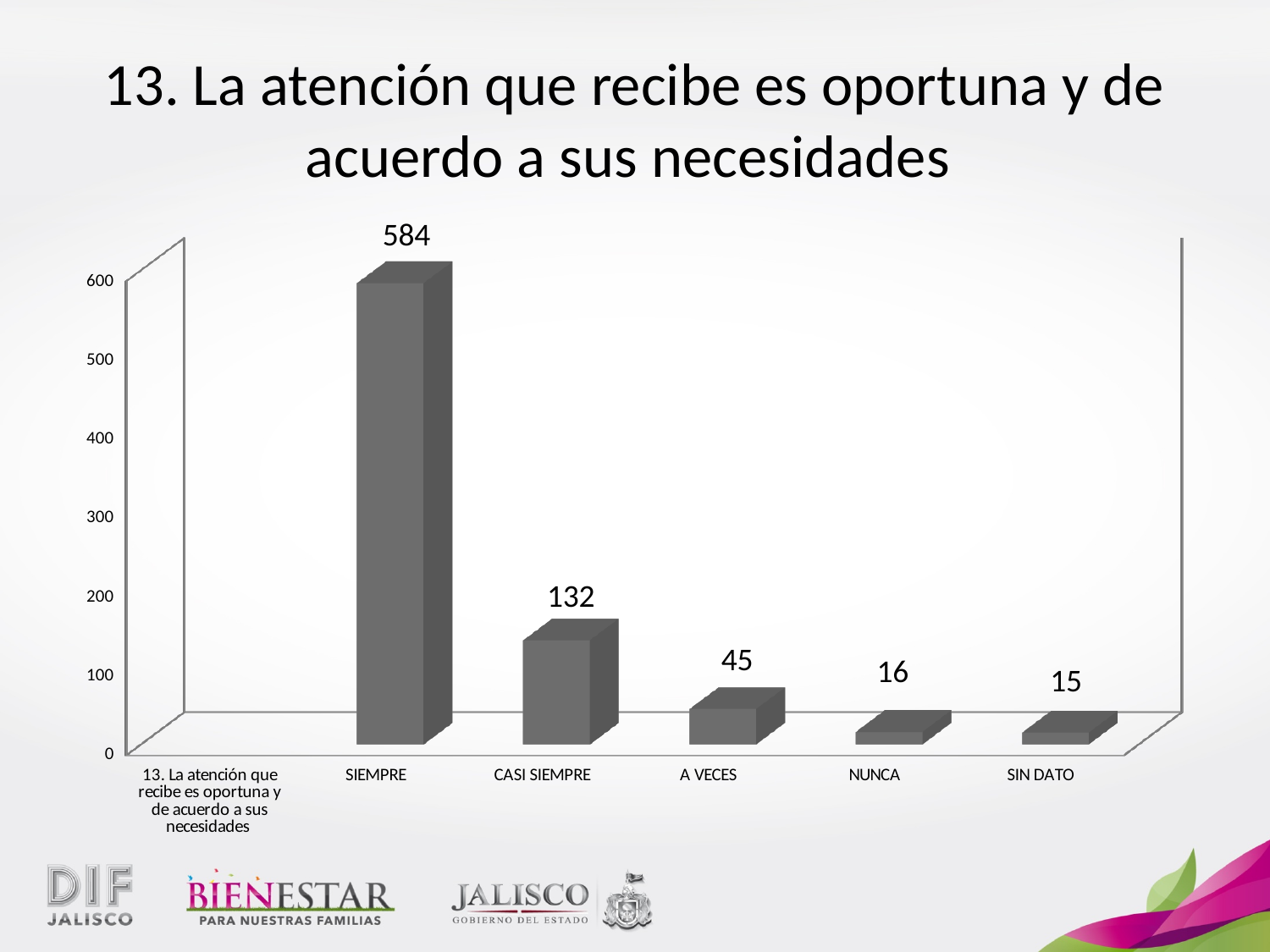
What kind of chart is shown on the slide? bar chart What is the value for A VECES? 45 Which category has the highest value? SIEMPRE What is the difference between the values for SIEMPRE and CASI SIEMPRE? 452 What is the value for NUNCA? 16 Which category has the lowest value? SIN DATO What is the value for SIN DATO? 15 Which is larger, the value for A VECES or the value for NUNCA? A VECES What is the value for CASI SIEMPRE? 132 How many bars are plotted in the chart? 5 Is the value for SIEMPRE greater or less than 500? greater What is the value for SIEMPRE? 584